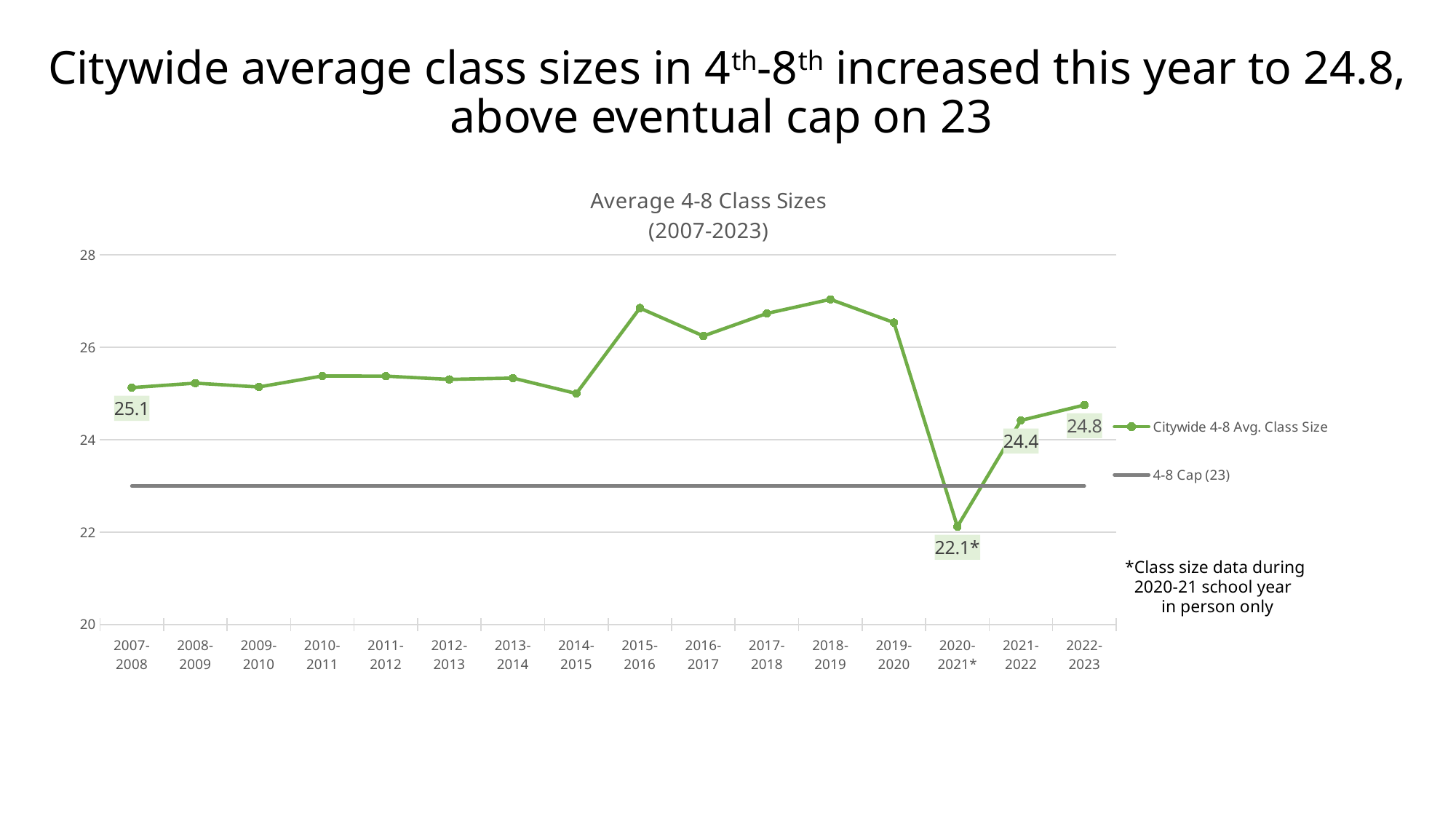
What is the citywide 4-8 average class size for 2020-2021*? 22.1* What is the difference between the citywide 4-8 average class size in 2022-2023 and in 2021-2022? 0.4 Is the citywide 4-8 average class size for 2014-2015 greater or less than 26? less Which school year has the highest citywide 4-8 average class size? 2018-2019 How many school years are shown on the x axis? 16 What is the citywide 4-8 average class size for 2022-2023? 24.8 What is the difference between the citywide 4-8 average class size in 2007-2008 and in 2020-2021*? 3.0 Is the citywide 4-8 average class size for 2015-2016 greater or less than 26? greater What is the citywide 4-8 average class size for 2007-2008? 25.1 How many series does the legend list? 2 What kind of chart is shown on the slide? Line chart Which school year has the lowest citywide 4-8 average class size? 2020-2021*